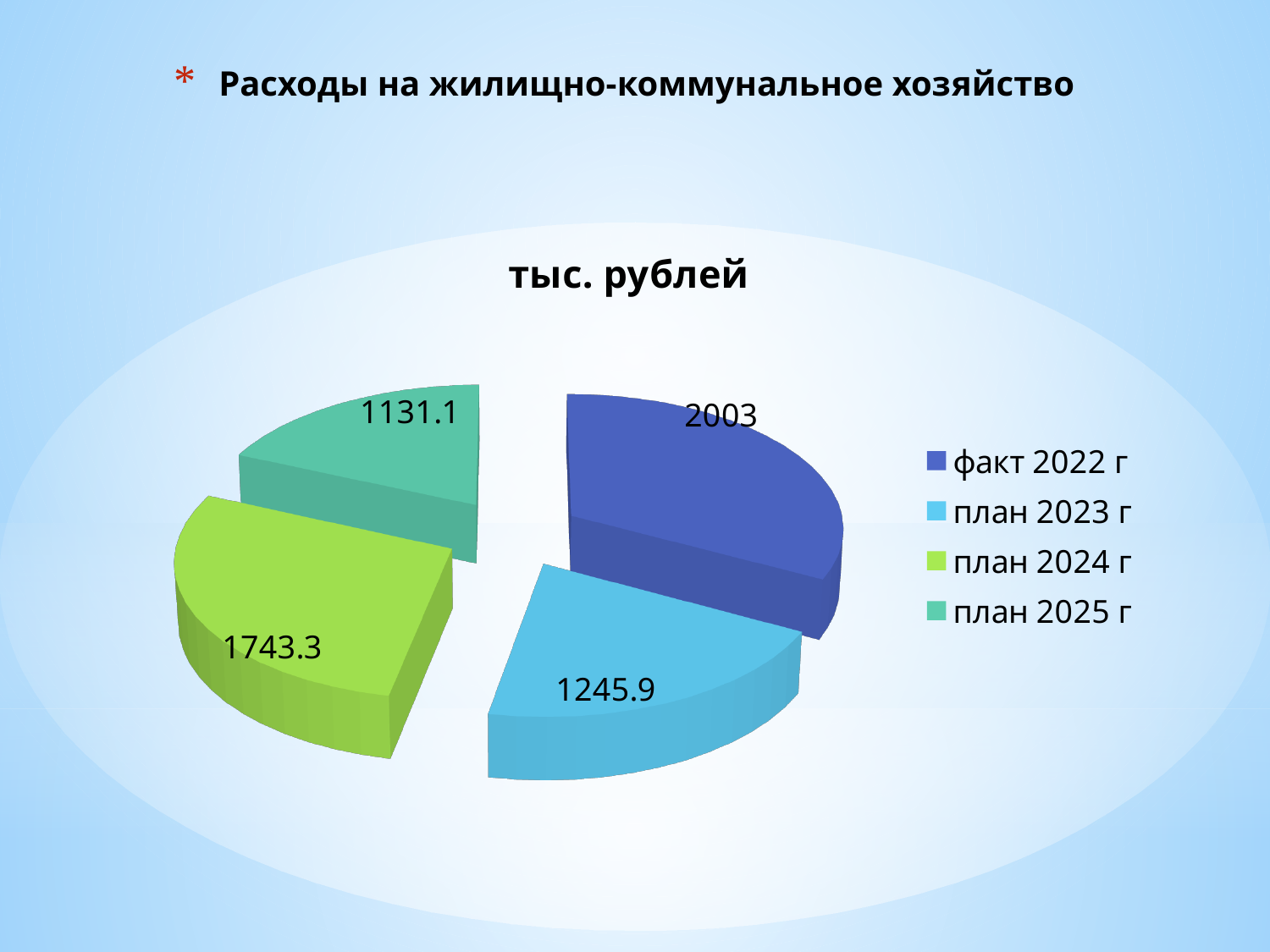
What is the difference between the values for факт 2022 г and план 2025 г? 871.9 How many slices does the pie chart have? 4 How many entries does the legend list? 4 Which category has the largest slice? факт 2022 г What is the value for план 2025 г? 1131.1 What kind of chart is shown on the slide? pie chart What is the value for план 2023 г? 1245.9 Which is larger, план 2024 г or план 2023 г? план 2024 г What is the title of the chart? тыс. рублей What is the value for план 2024 г? 1743.3 Which category has the smallest slice? план 2025 г What is the value for факт 2022 г? 2003